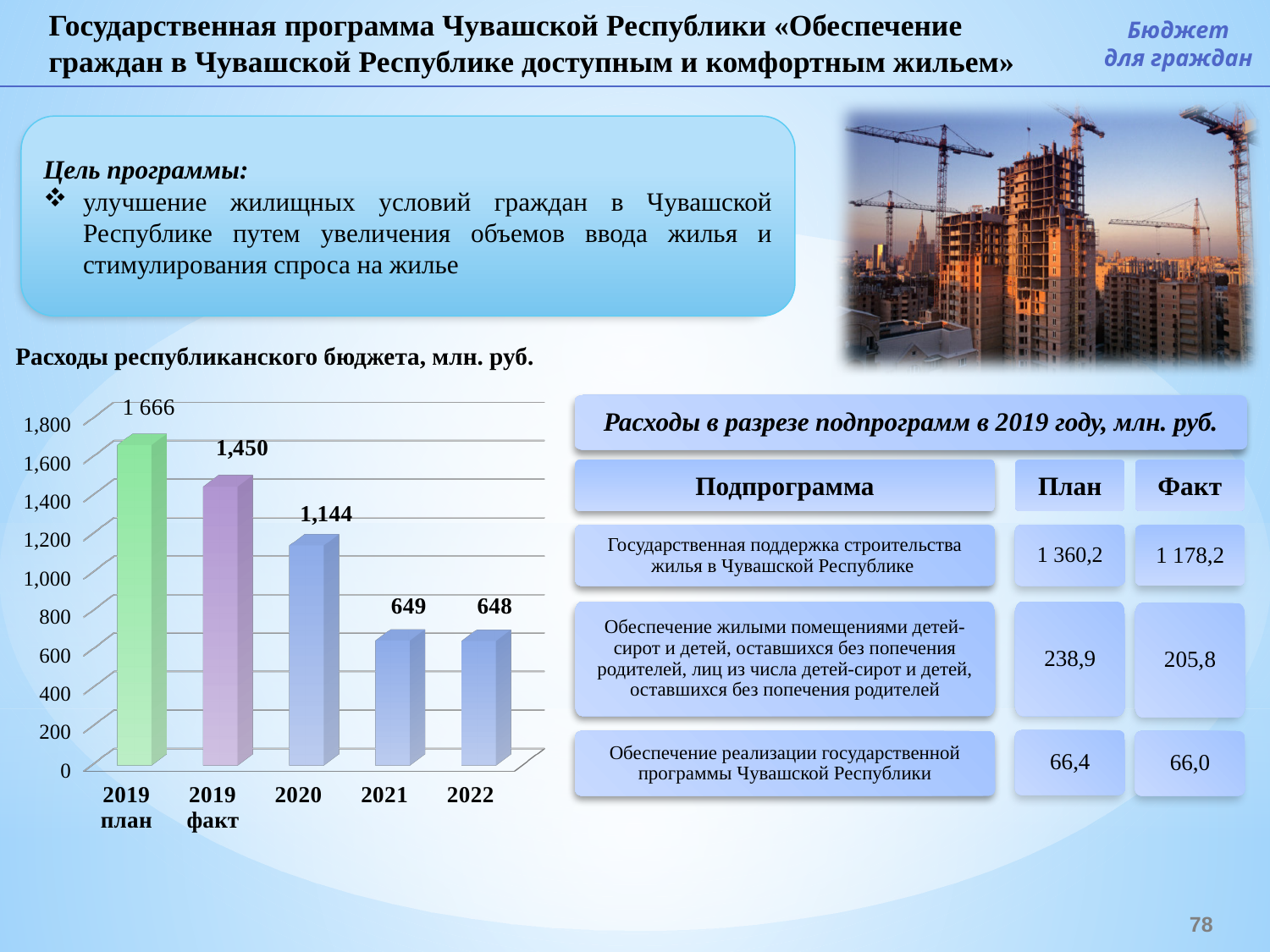
Which is larger, the value for 2019 факт or the value for 2021? 2019 факт What kind of chart is shown on the slide? bar chart Which category has the highest value in the chart? 2019 план Is the value for 2020 greater or less than 1,000? greater Do the values rise or fall from left to right along the x axis of the chart? fall What is the value for 2020 in the chart? 1,144 How many categories are shown on the x axis of the chart? 5 What is the value for 2019 факт in the chart? 1,450 What is the difference between the values for 2019 факт and 2020? 306 What is the value for 2021 in the chart? 649 What is the difference between the values for 2019 план and 2019 факт? 216 What is the value for 2019 план in the chart 'Расходы республиканского бюджета, млн. руб.'? 1 666